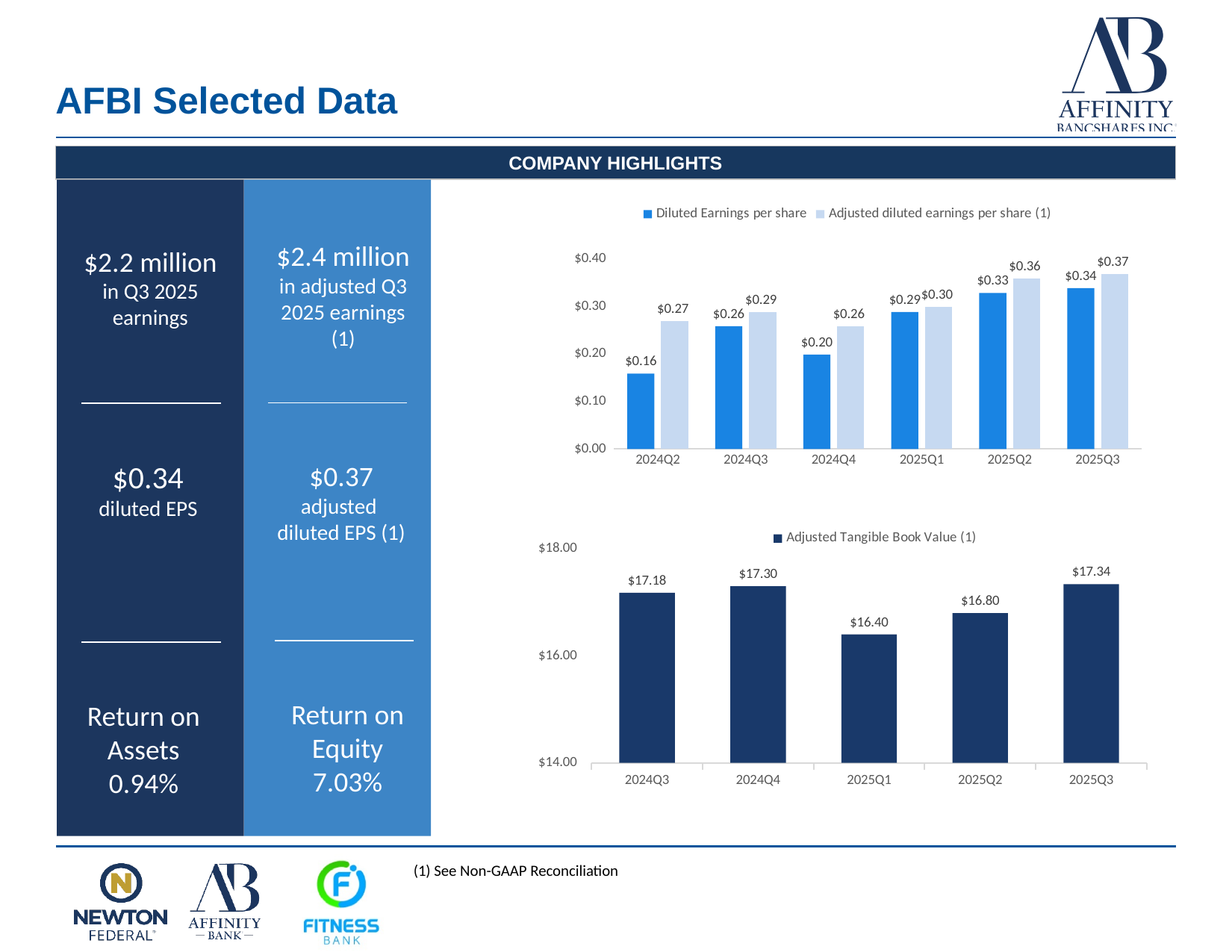
In the bottom chart (Adjusted Tangible Book Value), which quarter has the highest value? 2025Q3 In the top chart (earnings per share), which quarter has the highest Adjusted diluted earnings per share? 2025Q3 In the bottom chart (Adjusted Tangible Book Value), which quarter has the lowest value? 2025Q1 In the top chart (earnings per share), what is the Diluted Earnings per share value for 2024Q2? $0.16 In the top chart (earnings per share), what is the difference between Adjusted diluted earnings per share and Diluted Earnings per share in 2024Q4? $0.06 In the top chart (earnings per share), how many series does the legend list? 2 In the bottom chart (Adjusted Tangible Book Value), what is the difference between the 2025Q3 and 2025Q2 values? $0.54 In the top chart (earnings per share), what is the Adjusted diluted earnings per share value for 2025Q3? $0.37 In the top chart (earnings per share), which quarter has the lowest Diluted Earnings per share? 2024Q2 In the bottom chart (Adjusted Tangible Book Value), what is the value for 2025Q1? $16.40 In the top chart (earnings per share), how many quarters are shown on the x axis? 6 What kind of chart is the bottom chart (Adjusted Tangible Book Value)? Bar chart